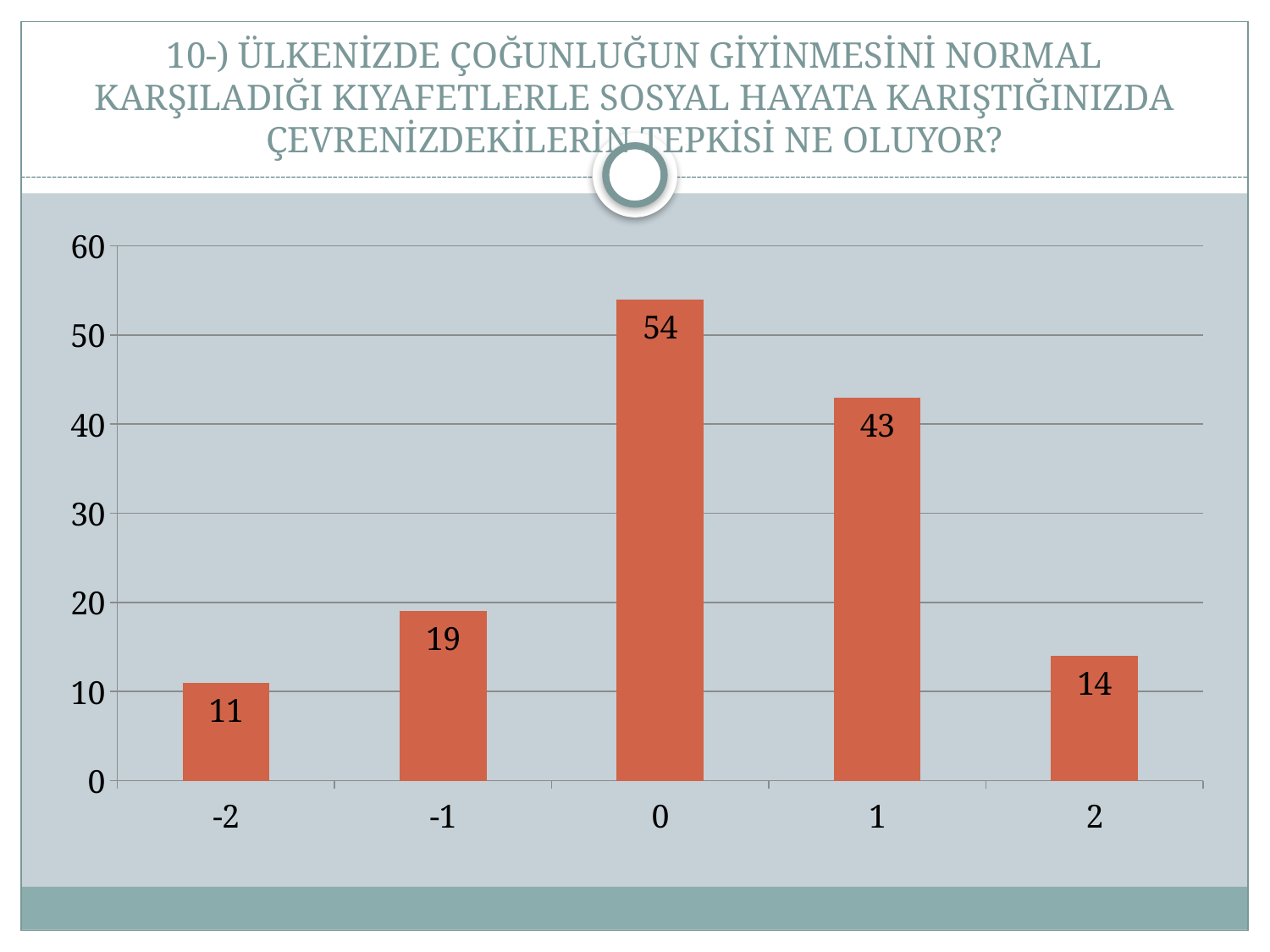
What is the highest value shown on the y axis? 60 Which is larger, the value for category -1 or the value for category 2? -1 What is the value for category 0? 54 Which category has the highest value? 0 What is the value for category -2? 11 Which category has the lowest value? -2 What kind of chart is shown on the slide? bar chart Is the value for category 1 greater or less than 40? greater How many categories are shown on the x axis? 5 What is the difference between the values for category 0 and category 1? 11 What is the value for category 2? 14 What is the difference between the values for category -1 and category -2? 8